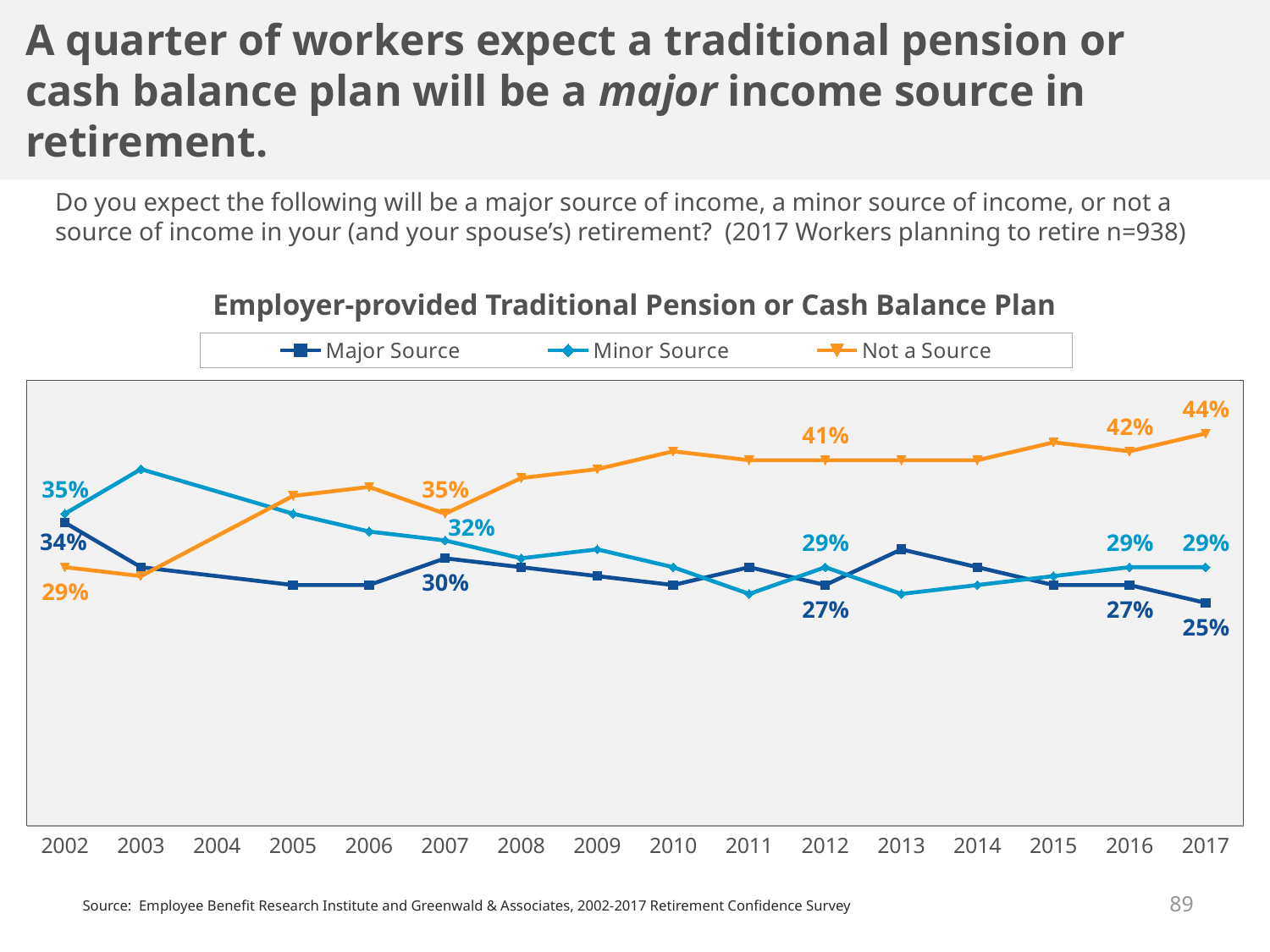
In 2017, how many percentage points higher is 'Not a Source' than 'Major Source'? 19 percentage points In 2002, which was larger: 'Major Source' or 'Minor Source'? Minor Source What kind of chart is shown on the slide? Line chart What was the 'Major Source' value in 2017? 25% Which series has the highest value in 2017? Not a Source How many series does the legend list? 3 What was the 'Major Source' value in 2002? 34% How many years are shown on the x axis? 16 What was the 'Not a Source' value in 2012? 41% By how many percentage points did 'Not a Source' increase from 2002 to 2017? 15 percentage points What was the 'Minor Source' value in 2007? 32% What percentage of workers said an employer-provided traditional pension or cash balance plan would be 'Not a Source' of retirement income in 2017? 44%